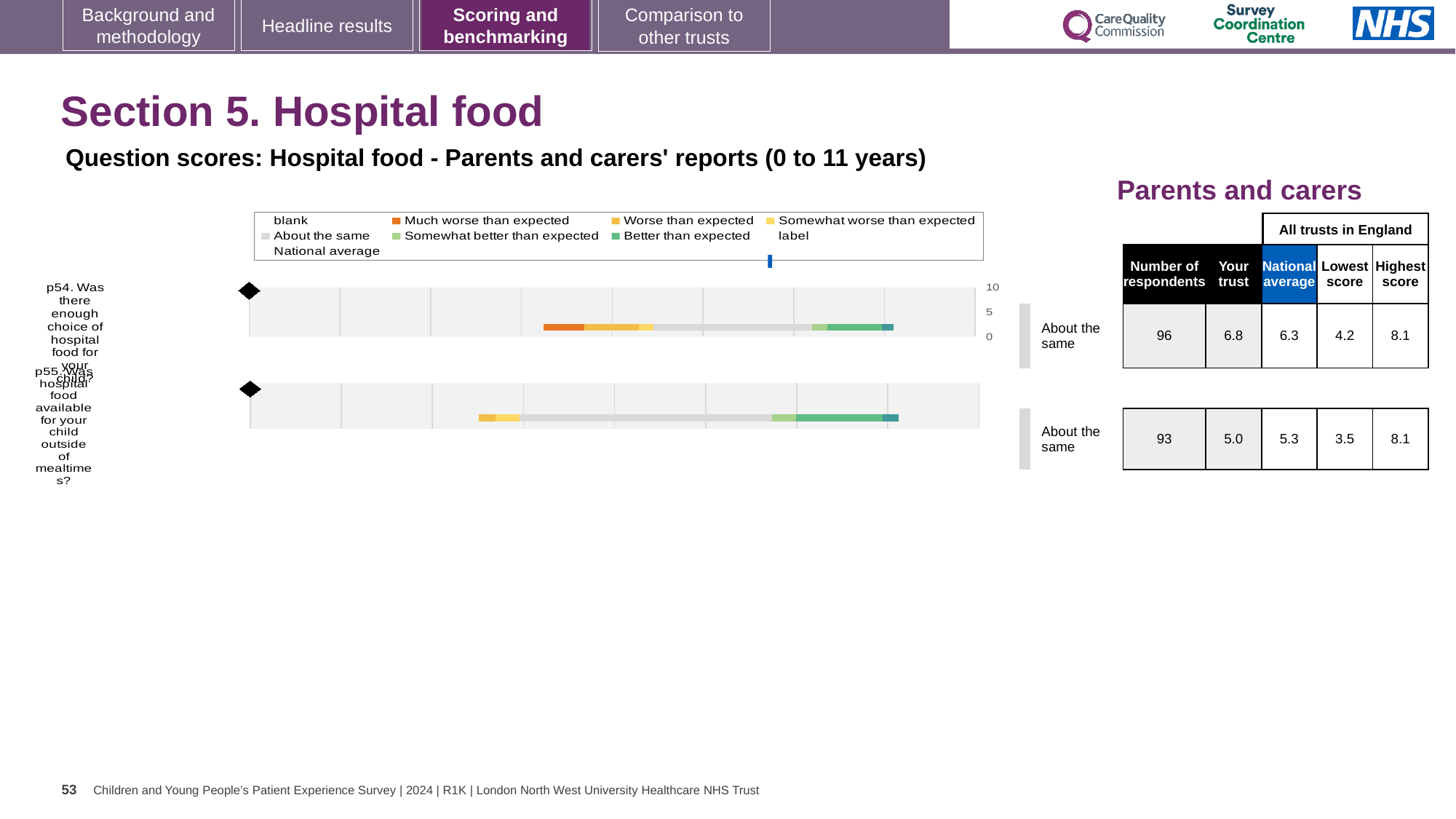
In the table beside the chart, what is the national average for p55 (hospital food available outside of mealtimes)? 5.3 In the table beside the chart, what is the 'Your trust' score for p54 (enough choice of hospital food)? 6.8 In the table beside the chart, what is the highest score across all trusts in England for p54? 8.1 In the table beside the chart, how many respondents answered p55 (hospital food available outside of mealtimes)? 93 What is the difference between the 'Your trust' score and the national average for p54? 0.5 How many survey questions (bars) are plotted in the chart? 2 What kind of chart is shown on the slide? bar chart What benchmark category is shown next to the bar for p54 (enough choice of hospital food)? About the same For p54, which is larger: the 'Your trust' score or the national average? Your trust For p55, which is larger: the 'Your trust' score or the national average? National average What is the difference between the lowest scores for p54 and p55 in the table? 0.7 Which colour does the legend use for 'Much worse than expected'? orange